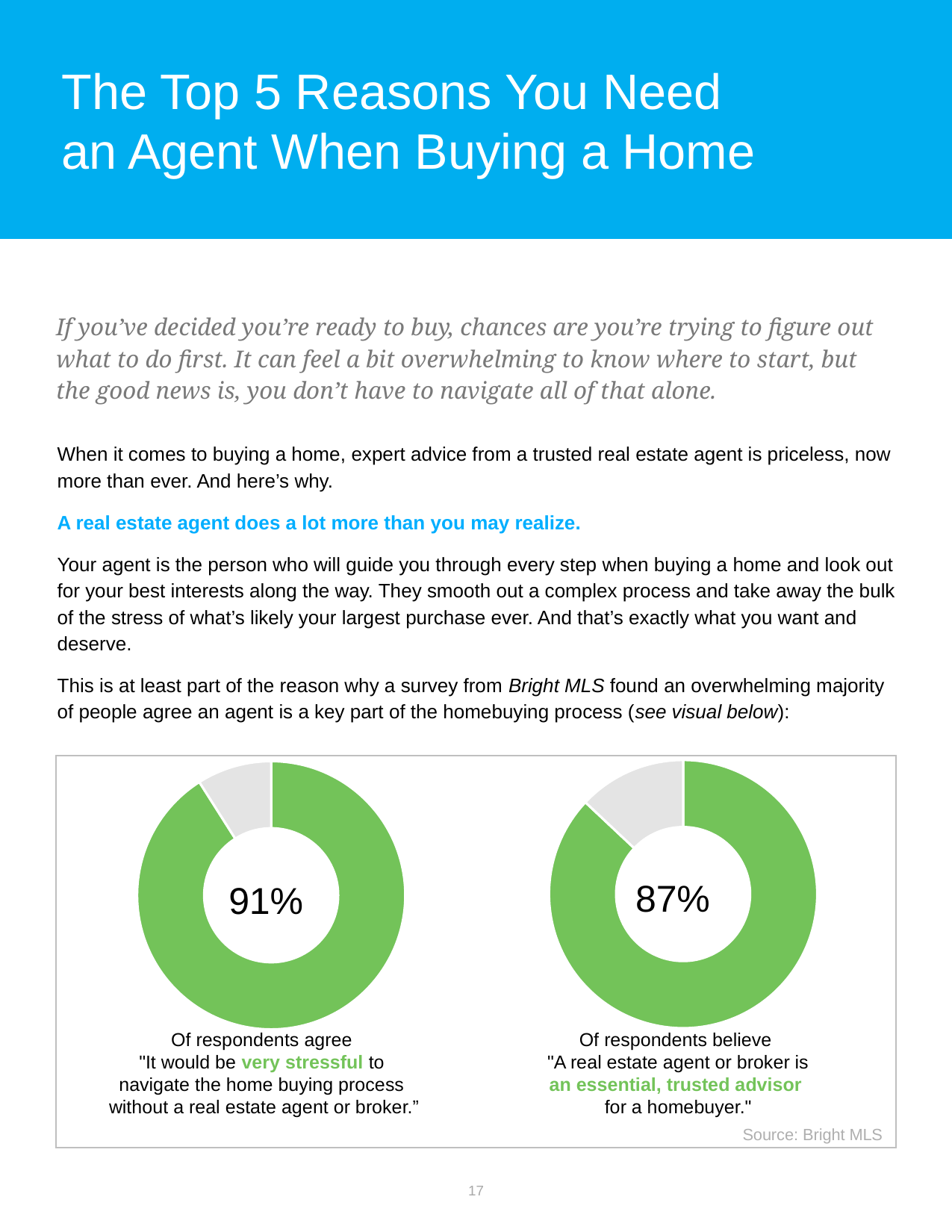
Is the value shown in the left donut chart greater or less than 90%? greater In the left donut chart, what percentage of respondents agree it would be very stressful to navigate the home buying process without a real estate agent or broker? 91% In the left donut chart, what share of the ring is taken up by the green segment? 91% What source is cited for the survey data shown in the donut charts? Bright MLS Is the value shown in the right donut chart greater or less than 90%? less In the right donut chart, what share of the ring is taken up by the green segment? 87% How many donut charts are shown in the visual on this slide? 2 What is the difference in percentage points between the left donut chart (91%) and the right donut chart (87%)? 4 percentage points In the right donut chart, what percentage of respondents believe a real estate agent or broker is an essential, trusted advisor for a homebuyer? 87% What kind of chart is used to show the survey results on this slide? Donut (pie) chart Which donut chart shows the larger percentage, the left one (very stressful without an agent) or the right one (essential, trusted advisor)? The left one (91%) What colour is used for the larger segment in both donut charts? Green